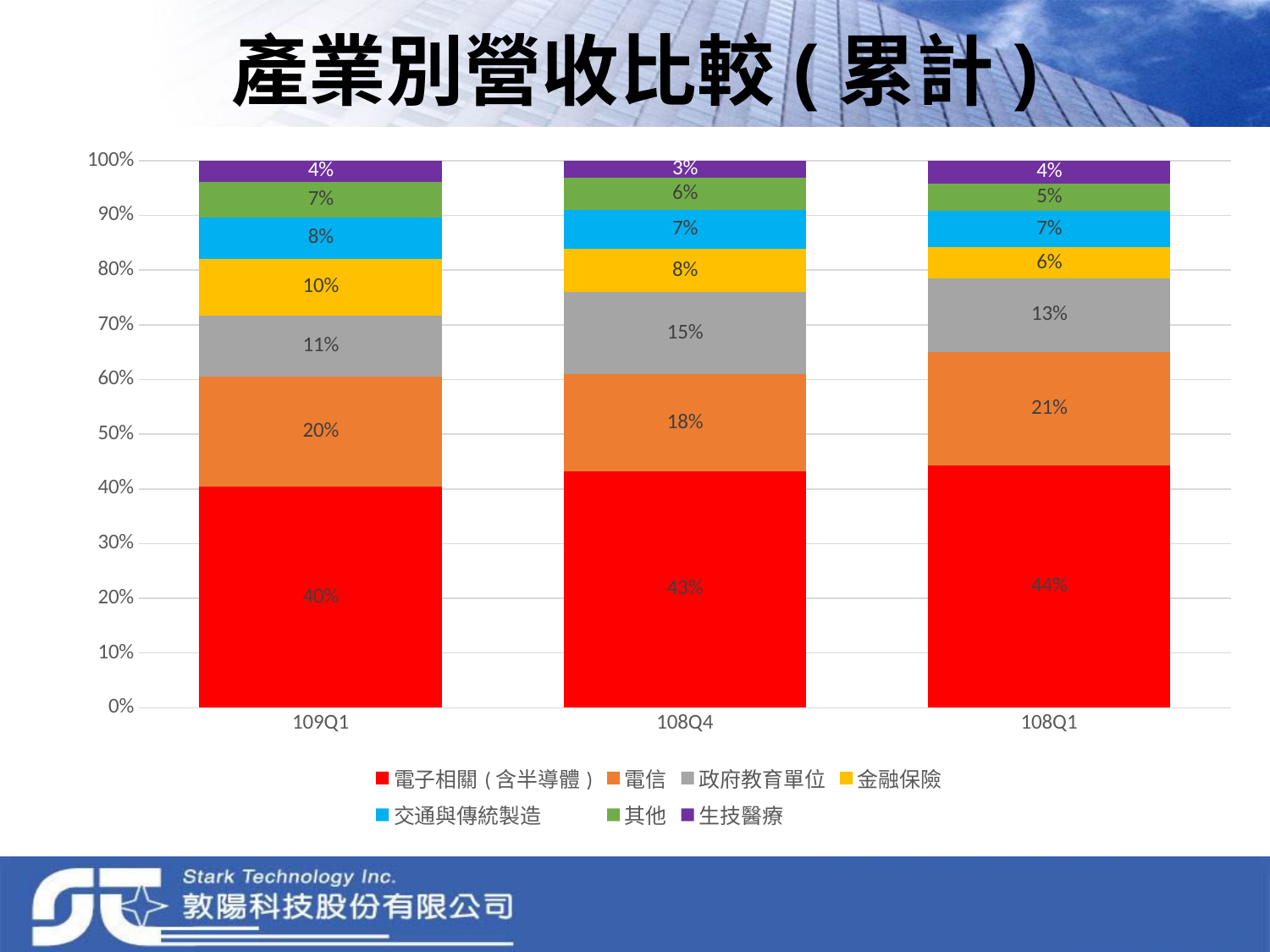
What is the share of 金融保險 in 109Q1? 10% In which period is the share of 電子相關（含半導體） the highest? 108Q1 What kind of chart is shown on the slide? Stacked bar chart Which series is shown in red in the chart? 電子相關（含半導體） How many periods (categories) are shown on the x axis? 3 What is the share of 政府教育單位 in 108Q4? 15% What is the share of 電子相關（含半導體） in 109Q1? 40% What is the difference between the 電信 share in 108Q1 and in 108Q4? 3% How many series does the legend list? 7 Which is larger: the 金融保險 share in 109Q1 or in 108Q1? 109Q1 What is the share of 電信 in 108Q1? 21% In which period is the share of 生技醫療 the lowest? 108Q4